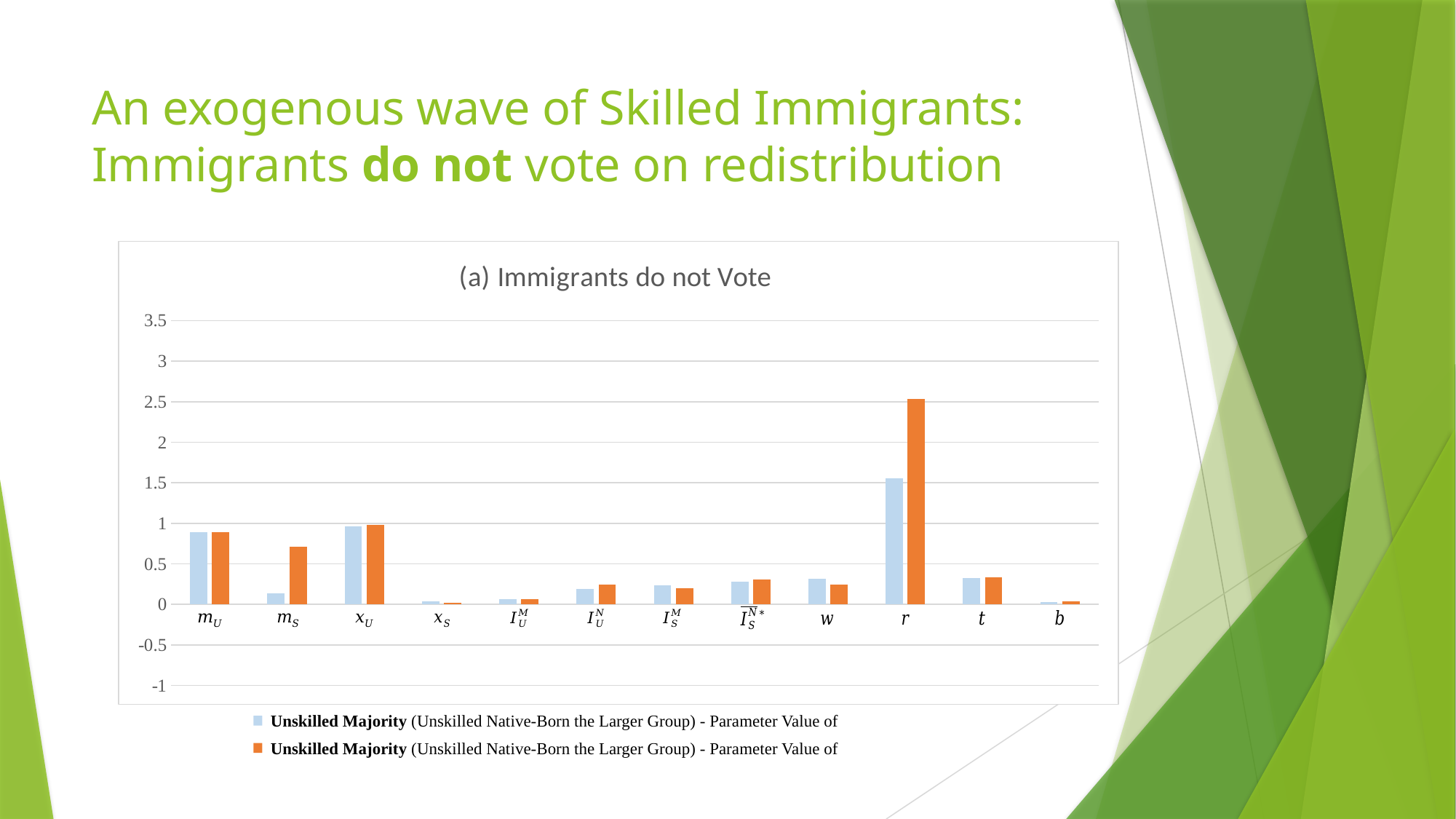
What kind of chart is shown on the slide? bar chart Is the orange bar for r greater or less than 2? greater For the category w, which bar is taller, the blue one or the orange one? blue What is the title of the chart? (a) Immigrants do not Vote Which category has the tallest blue bar? r Is the blue bar for r greater or less than 1? greater Which category has the tallest orange bar? r How many series does the chart's legend list? 2 For the category m_S, which bar is taller, the blue one or the orange one? orange How many categories are shown along the x axis of the chart? 12 Is the orange bar for m_S greater or less than 0.5? greater